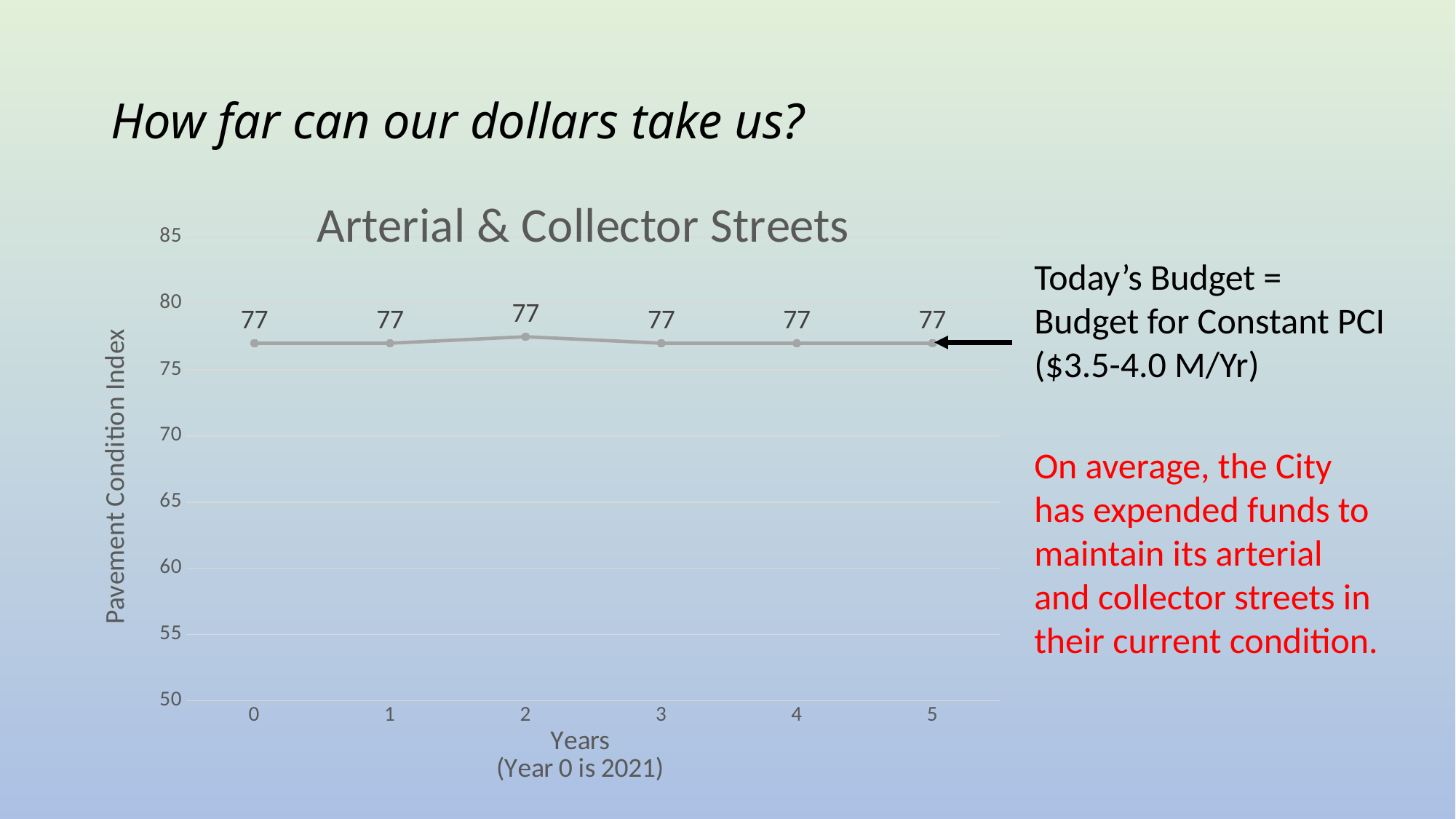
What is the Pavement Condition Index value at year 0? 77 Do the Pavement Condition Index values rise, fall, or stay flat from year 0 to year 5? stay flat What is the label of the vertical axis? Pavement Condition Index How many data points are plotted on the chart? 6 What is the Pavement Condition Index value at year 5? 77 What is the title of the chart? Arterial & Collector Streets Is the Pavement Condition Index value at year 4 greater or less than 80? less What is the difference between the Pavement Condition Index at year 5 and at year 0? 0 What kind of chart is shown on the slide? line chart Is the Pavement Condition Index value at year 2 greater or less than 70? greater What is the Pavement Condition Index value at year 3? 77